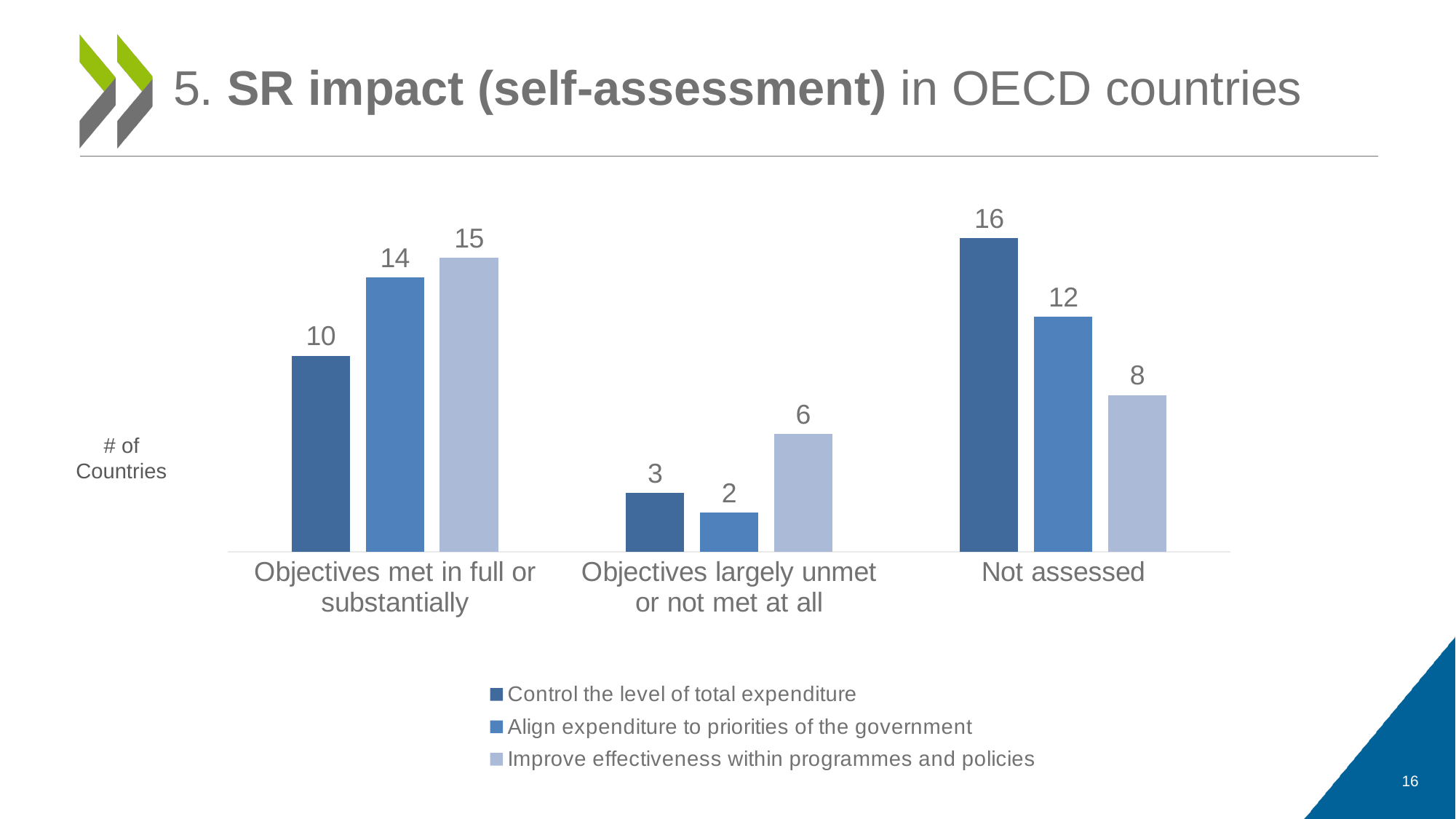
Which category has the lowest value for the 'Improve effectiveness within programmes and policies' series? Objectives largely unmet or not met at all What is the value for 'Improve effectiveness within programmes and policies' in the 'Not assessed' category? 8 In the 'Objectives met in full or substantially' category, which series has the larger value: 'Control the level of total expenditure' or 'Improve effectiveness within programmes and policies'? Improve effectiveness within programmes and policies What is the difference between the 'Align expenditure to priorities of the government' values for 'Objectives met in full or substantially' and 'Not assessed'? 2 Which category has the highest value for the 'Control the level of total expenditure' series? Not assessed What is the difference between the 'Control the level of total expenditure' and 'Improve effectiveness within programmes and policies' values in the 'Not assessed' category? 8 What kind of chart is shown on the slide? Bar chart What is the label on the vertical axis of the chart? # of Countries What is the value for 'Align expenditure to priorities of the government' in the 'Objectives largely unmet or not met at all' category? 2 How many categories are shown on the x axis of the chart? 3 How many series does the legend list? 3 How many countries reported 'Objectives met in full or substantially' for the 'Control the level of total expenditure' objective? 10